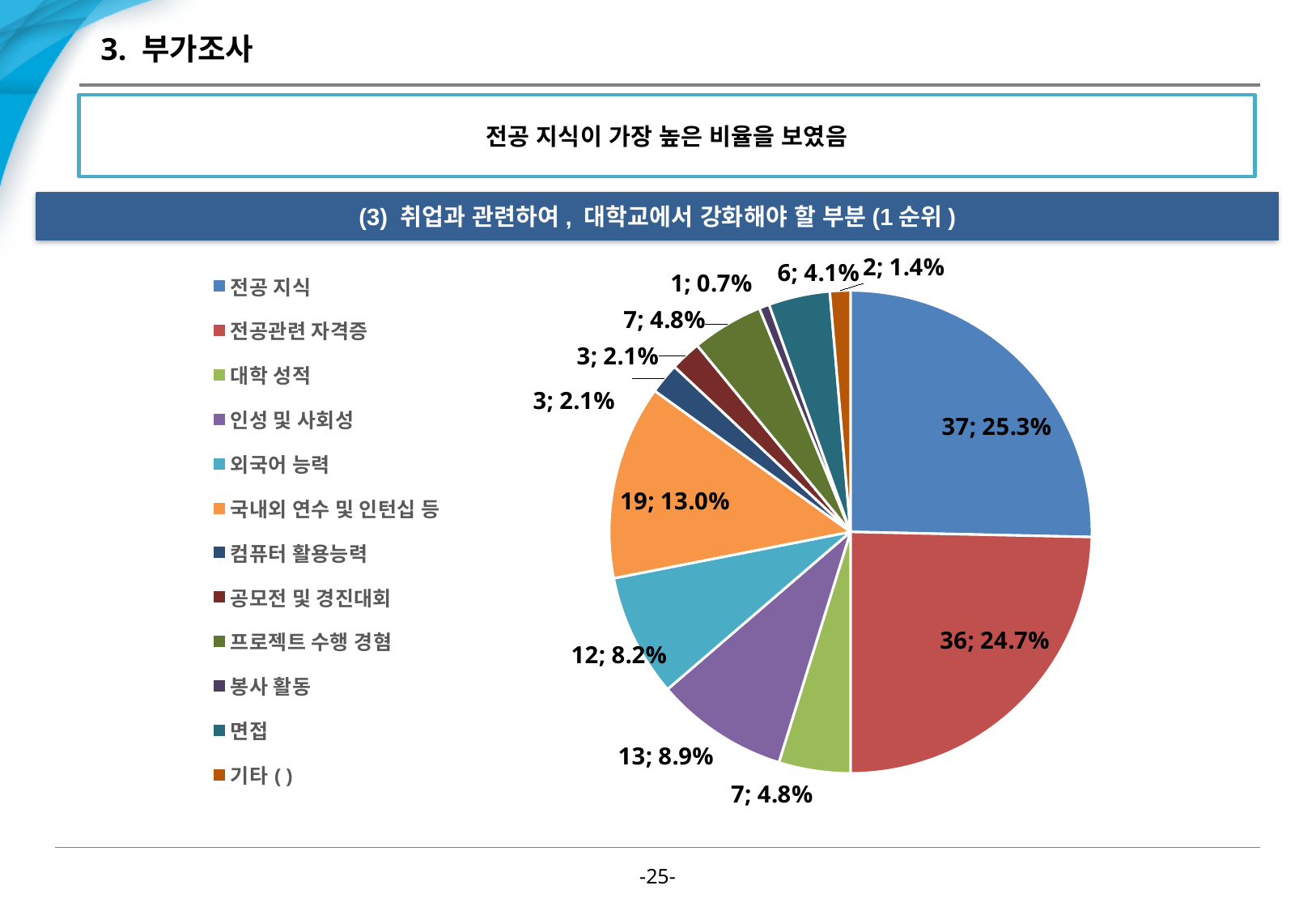
What is the value shown for 국내외 연수 및 인턴십 등? 19; 13.0% What share of the pie does 외국어 능력 represent? 8.2% What is the value shown for 전공 지식? 37; 25.3% What is the value shown for 면접? 6; 4.1% Which is larger, the slice for 인성 및 사회성 or the slice for 외국어 능력? 인성 및 사회성 Which category has the largest slice of the pie? 전공 지식 What is the difference in count between 전공 지식 and 전공관련 자격증? 1 Which category has the smallest slice of the pie? 봉사 활동 What is the title of the chart section on the slide? (3) 취업과 관련하여, 대학교에서 강화해야 할 부분 (1 순위) What kind of chart is shown on the slide? pie chart What share of the pie does 전공관련 자격증 represent? 24.7% How many categories does the pie chart have? 12